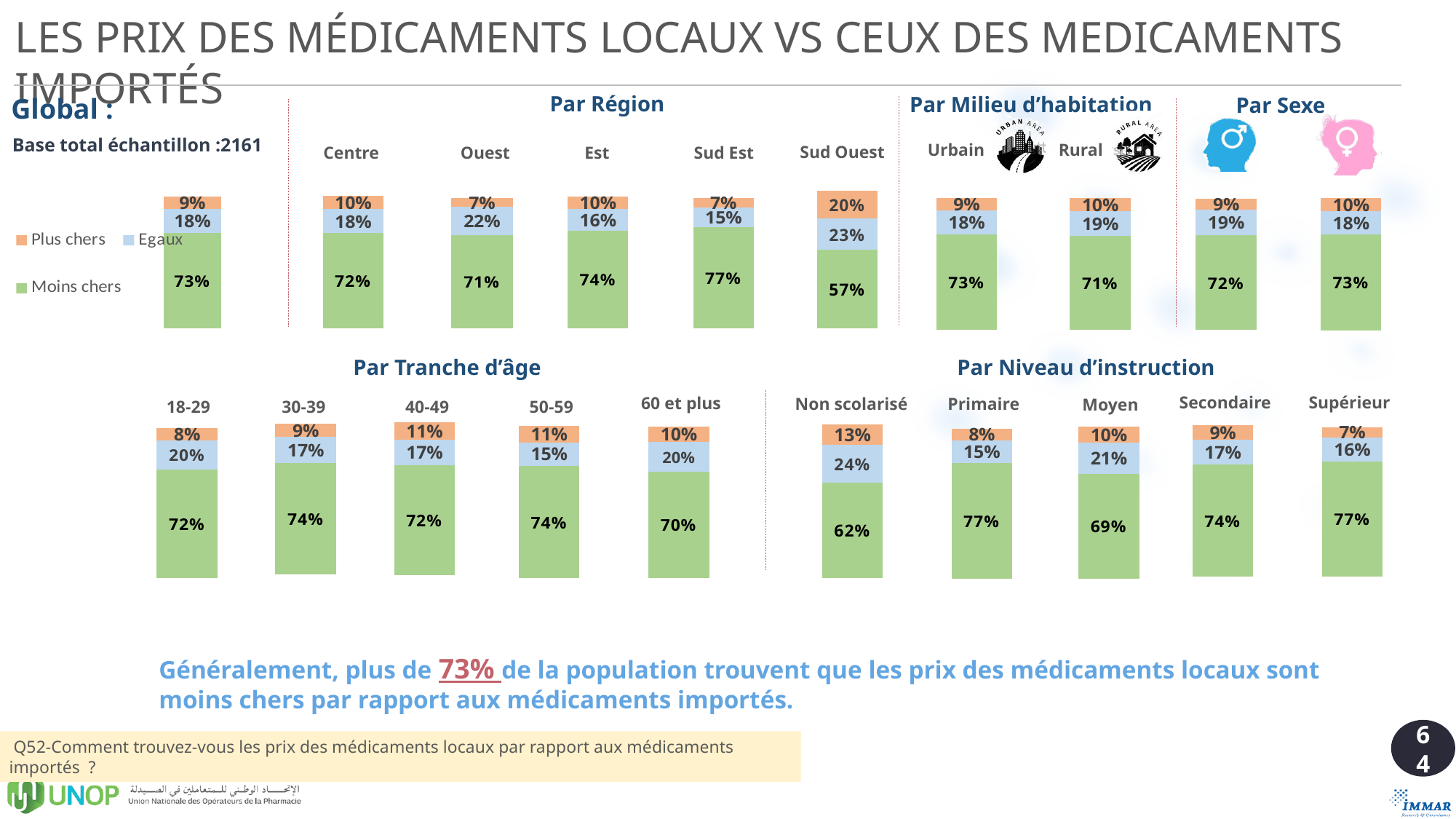
In the Par Milieu d'habitation chart, which has the larger 'Moins chers' value, Urbain or Rural? Urbain In the Par Tranche d'âge chart, what is the 'Moins chers' value for the 60 et plus group? 70% In the Par Région chart, what is the difference between the 'Moins chers' values for Sud Est and Sud Ouest? 20 percentage points In the Par Niveau d'instruction chart, what is the 'Egaux' value for Non scolarisé? 24% In the Global chart, what percentage of respondents find local medicines 'Moins chers'? 73% In the Par Tranche d'âge chart, how many age groups are shown? 5 In the Par Niveau d'instruction chart, which education level has the highest 'Plus chers' value? Non scolarisé In the Par Région chart, which region has the lowest 'Moins chers' value? Sud Ouest In the Par Région chart, what is the 'Plus chers' value for Sud Ouest? 20% How many series does the legend next to the Global chart list? 3 What kind of chart is used for the Par Niveau d'instruction section? Stacked bar chart In the Par Région chart, which region has the highest 'Moins chers' value? Sud Est